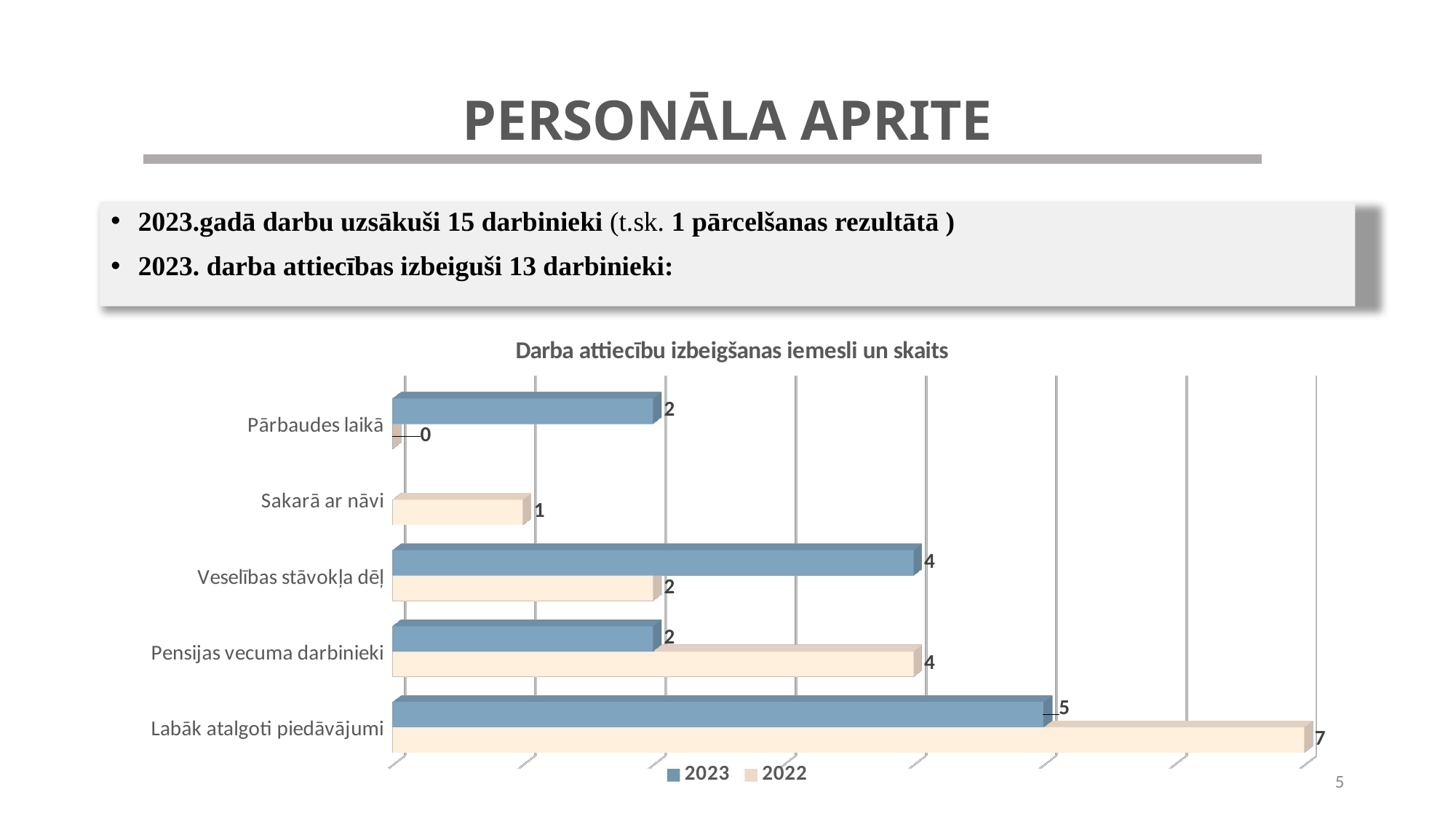
How many series does the legend list? 2 What is the value for 2022 in the "Labāk atalgoti piedāvājumi" category? 7 What type of chart is shown on the slide? Bar chart Which category has the highest value for the 2023 series? Labāk atalgoti piedāvājumi Which category has the highest value for the 2022 series? Labāk atalgoti piedāvājumi What is the value for 2023 in the "Labāk atalgoti piedāvājumi" category? 5 What is the difference between the 2022 and 2023 values for "Labāk atalgoti piedāvājumi"? 2 How many categories are shown on the chart? 5 In the "Pensijas vecuma darbinieki" category, which series has the larger value, 2023 or 2022? 2022 What is the value for 2022 in the "Sakarā ar nāvi" category? 1 What is the value for 2023 in the "Veselības stāvokļa dēļ" category? 4 What is the value for 2022 in the "Pārbaudes laikā" category? 0